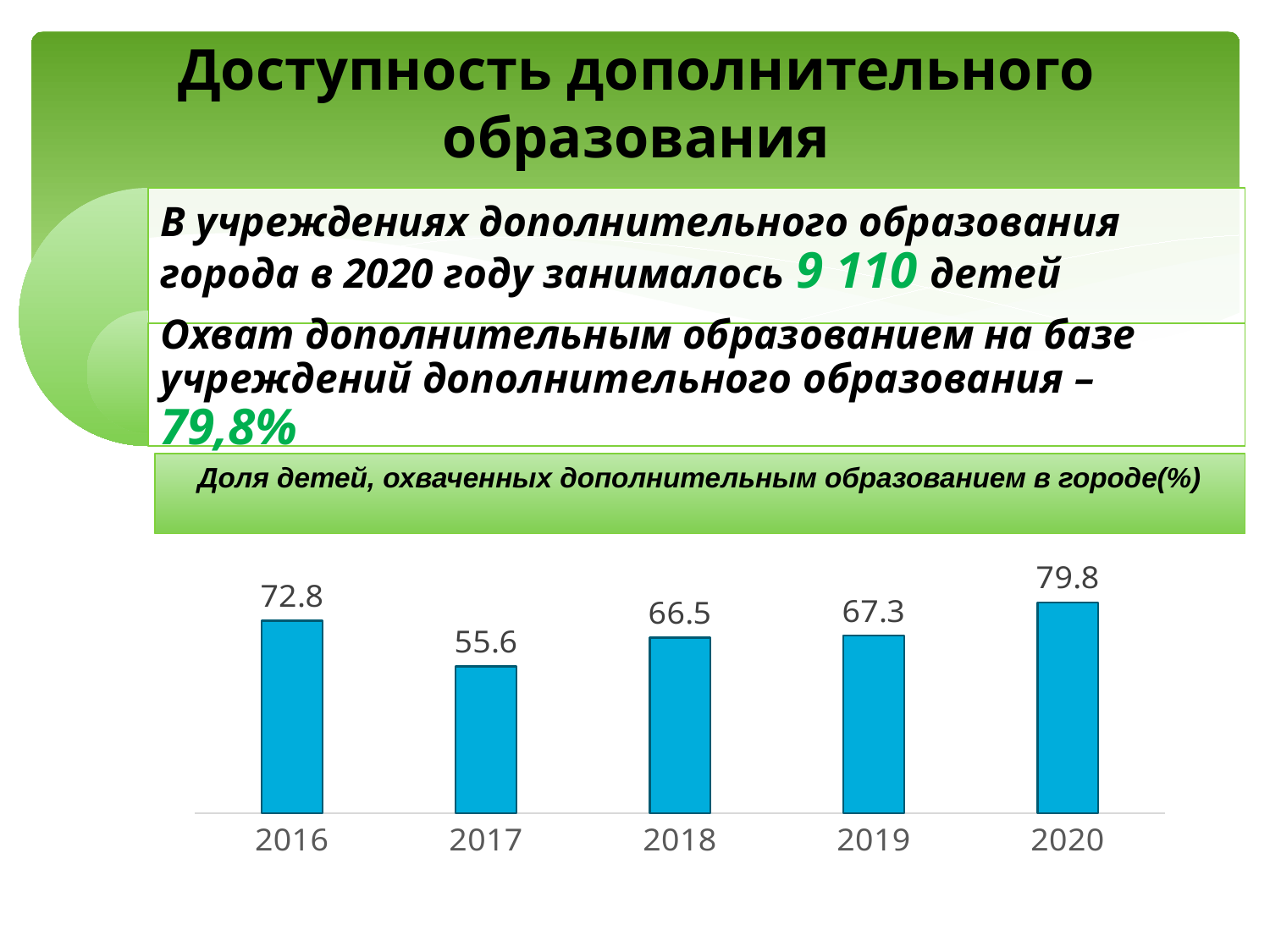
What is the value for 2016? 72.8 Which year has the highest value? 2020 What kind of chart is this? bar chart Which year has the lowest value? 2017 Do the values rise or fall from 2017 to 2020? rise What is the title of the chart? Доля детей, охваченных дополнительным образованием в городе(%) What is the difference between the values for 2019 and 2018? 0.8 What is the value for 2017? 55.6 How many years are shown on the chart? 5 What is the difference between the values for 2020 and 2016? 7 Which is larger, the value for 2016 or the value for 2018? 2016 What is the value for 2019? 67.3